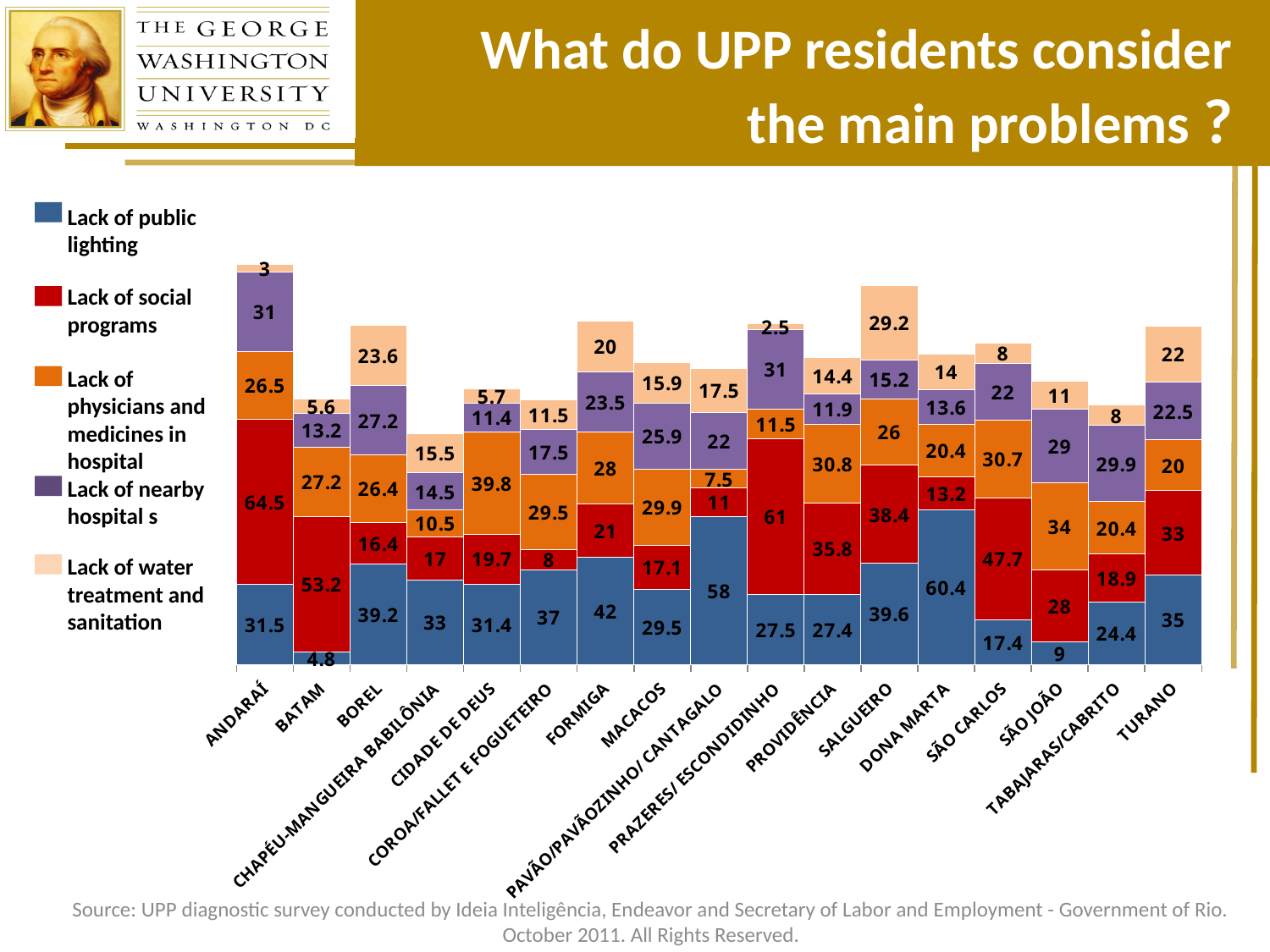
What kind of chart is shown on the slide? Stacked bar chart Which is larger: the Lack of public lighting value for FORMIGA or for TURANO? FORMIGA Which community has the lowest value for Lack of public lighting? BATAM What is the value for Lack of public lighting in DONA MARTA? 60.4 How many series does the legend list? 5 Which colour represents Lack of water treatment and sanitation in the legend? Peach (light orange) Which community has the highest value for Lack of public lighting? DONA MARTA What is the value for Lack of physicians and medicines in hospital in CIDADE DE DEUS? 39.8 What is the total of the stacked bar for ANDARAÍ? 156.5 What is the difference between the Lack of social programs values for ANDARAÍ and PRAZERES/ESCONDIDINHO? 3.5 How many communities (categories) are shown along the x axis? 17 What is the value for Lack of social programs in ANDARAÍ? 64.5